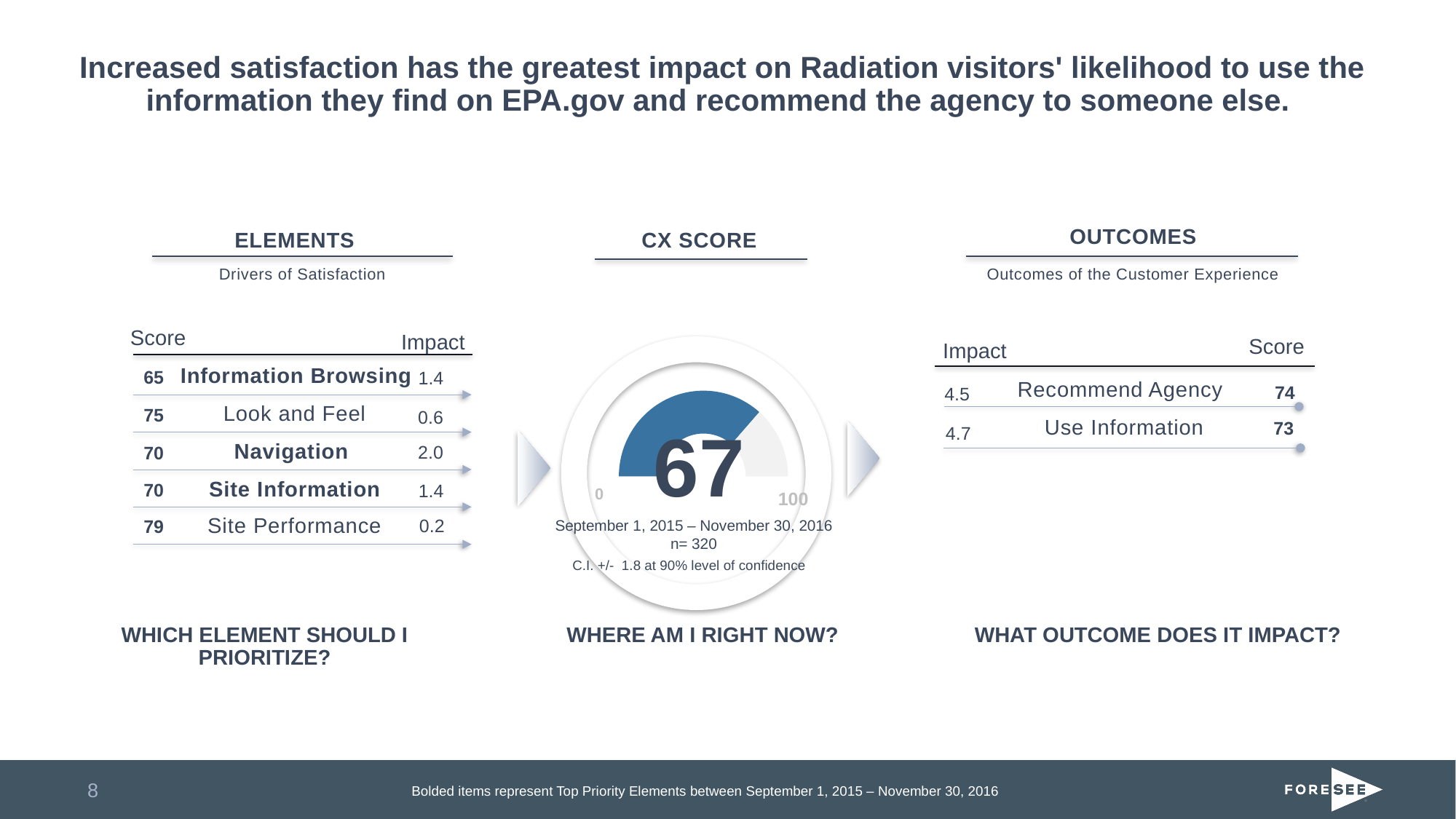
What is the confidence interval shown under the CX Score gauge? +/- 1.8 at 90% level of confidence What is the sample size (n) shown under the CX Score gauge? 320 What are the minimum and maximum values marked on the CX Score gauge? 0 and 100 What kind of chart is used to display the CX Score? gauge chart What is the CX Score shown on the gauge chart? 67 In the Elements table, what is the impact of Look and Feel? 0.6 In the Outcomes table, what is the impact value for Use Information? 4.7 In the Elements table, what is the score for Site Performance? 79 In the Outcomes table, what is the difference between the scores for Recommend Agency and Use Information? 1 In the Elements table, which element has the highest impact? Navigation In the Elements table, which element has the lowest score? Information Browsing How many elements are listed in the Elements table? 5